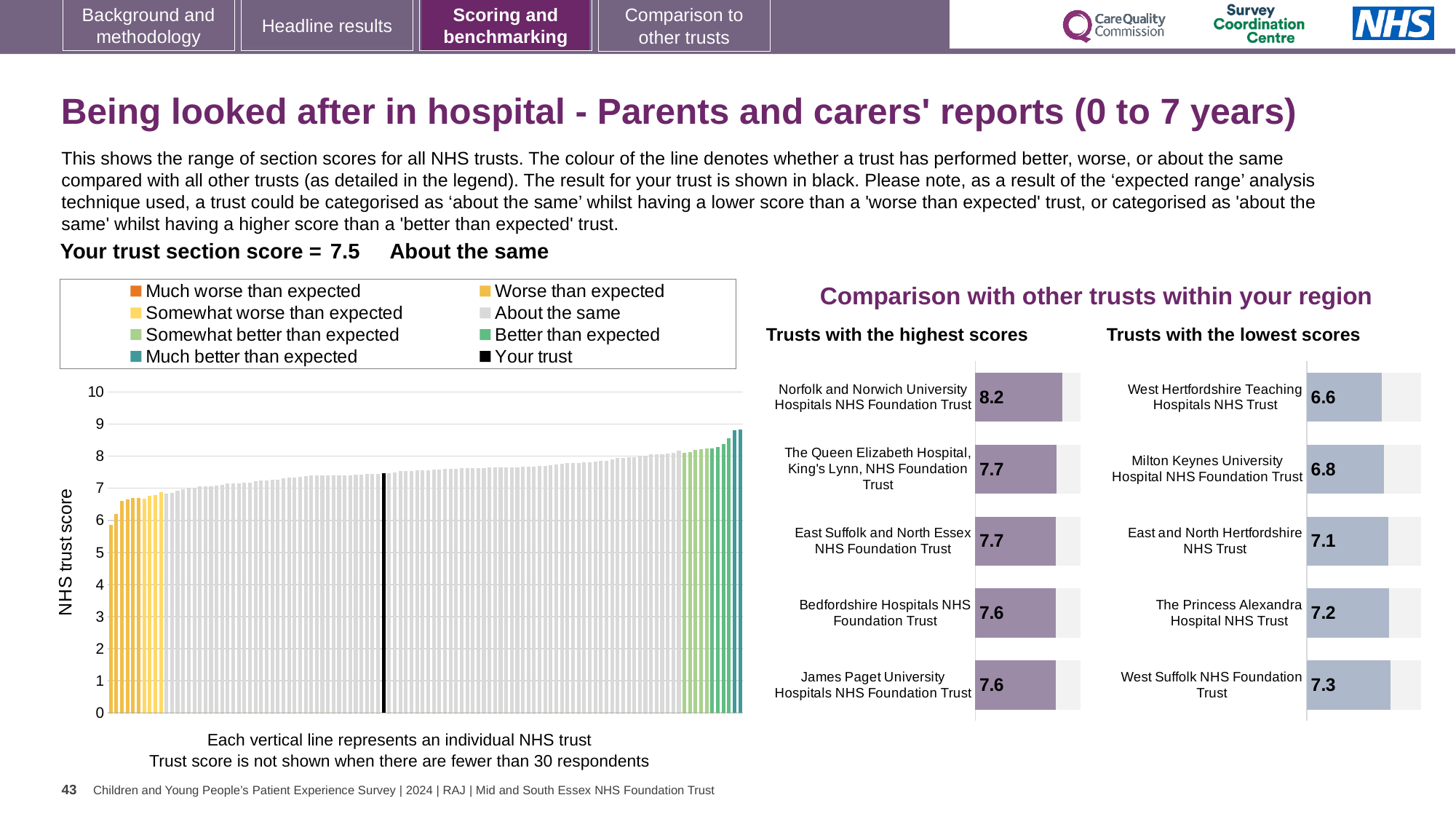
In the 'Trusts with the lowest scores' chart, which has the higher score: East and North Hertfordshire NHS Trust or The Princess Alexandra Hospital NHS Trust? The Princess Alexandra Hospital NHS Trust How many entries does the legend of the main chart on the left list? 8 In the 'Trusts with the lowest scores' chart, what is the score for Milton Keynes University Hospital NHS Foundation Trust? 6.8 In the 'Trusts with the highest scores' chart, what is the score for Norfolk and Norwich University Hospitals NHS Foundation Trust? 8.2 In the main chart on the left, do the trust scores rise or fall from left to right? Rise In the 'Trusts with the lowest scores' chart, what is the difference between the scores of West Suffolk NHS Foundation Trust and West Hertfordshire Teaching Hospitals NHS Trust? 0.7 In the 'Trusts with the highest scores' chart, what is the difference between the scores of Norfolk and Norwich University Hospitals NHS Foundation Trust and James Paget University Hospitals NHS Foundation Trust? 0.6 What kind of chart is the main chart on the left showing all NHS trusts? Bar chart In the 'Trusts with the lowest scores' chart, which trust has the lowest score? West Hertfordshire Teaching Hospitals NHS Trust How many trusts are listed in the 'Trusts with the highest scores' chart? 5 In the 'Trusts with the highest scores' chart, which trust has the highest score? Norfolk and Norwich University Hospitals NHS Foundation Trust What is the label on the vertical axis of the main chart on the left? NHS trust score